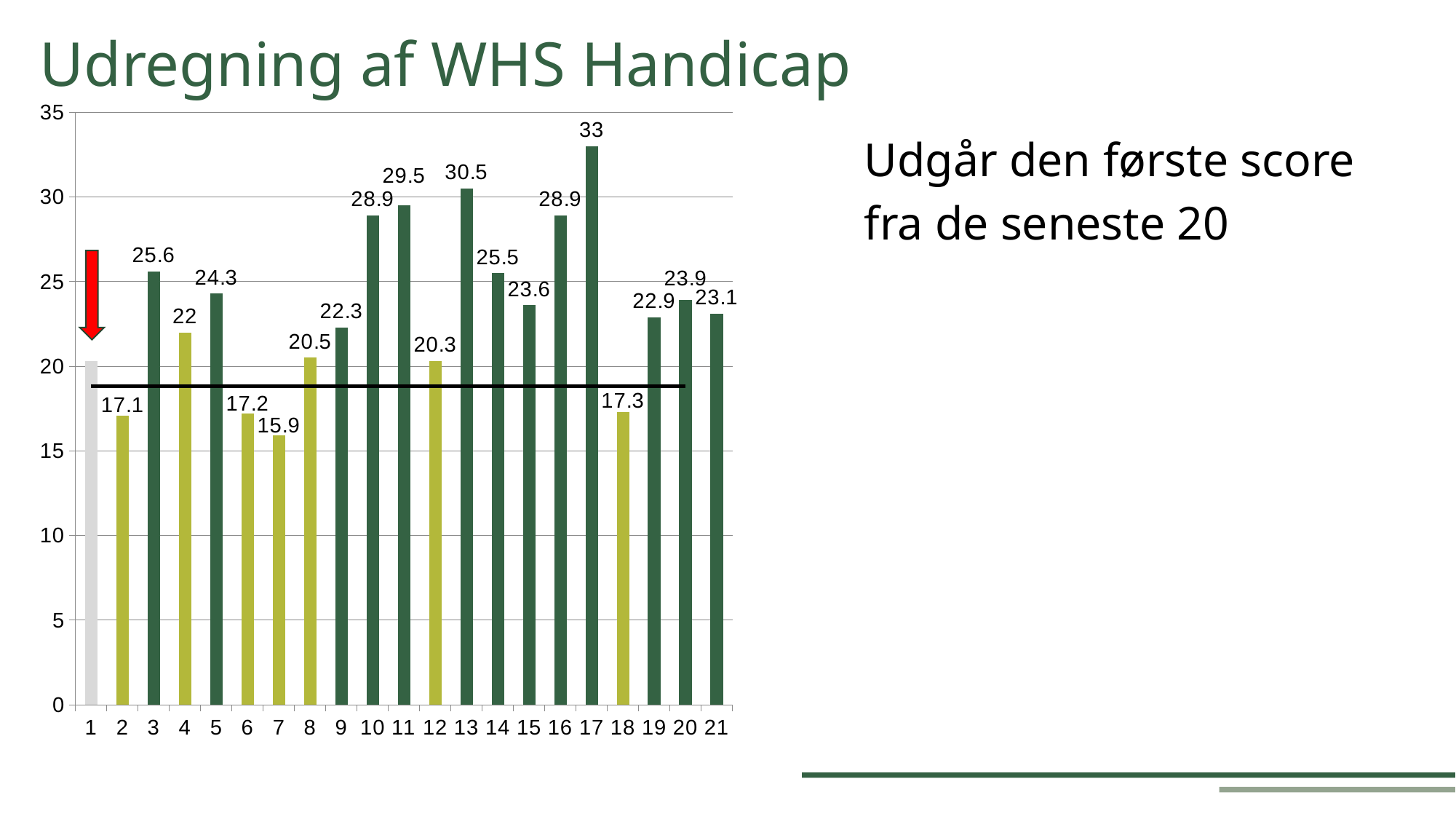
What kind of chart is shown on the slide? Combination bar and line chart (bars with a horizontal average line) What is the value for category 17? 33 Which is larger, the value for category 3 or the value for category 14? Category 3 What is the value for category 7? 15.9 Which category has the lowest value? 7 How many categories are shown on the x axis? 21 What is the difference between the values for category 17 and category 13? 2.5 What is the title of the slide containing the chart? Udregning af WHS Handicap What is the value for category 12? 20.3 What is the value for category 20? 23.9 Which category has the highest value? 17 Is the value for category 1 greater or less than 25? less